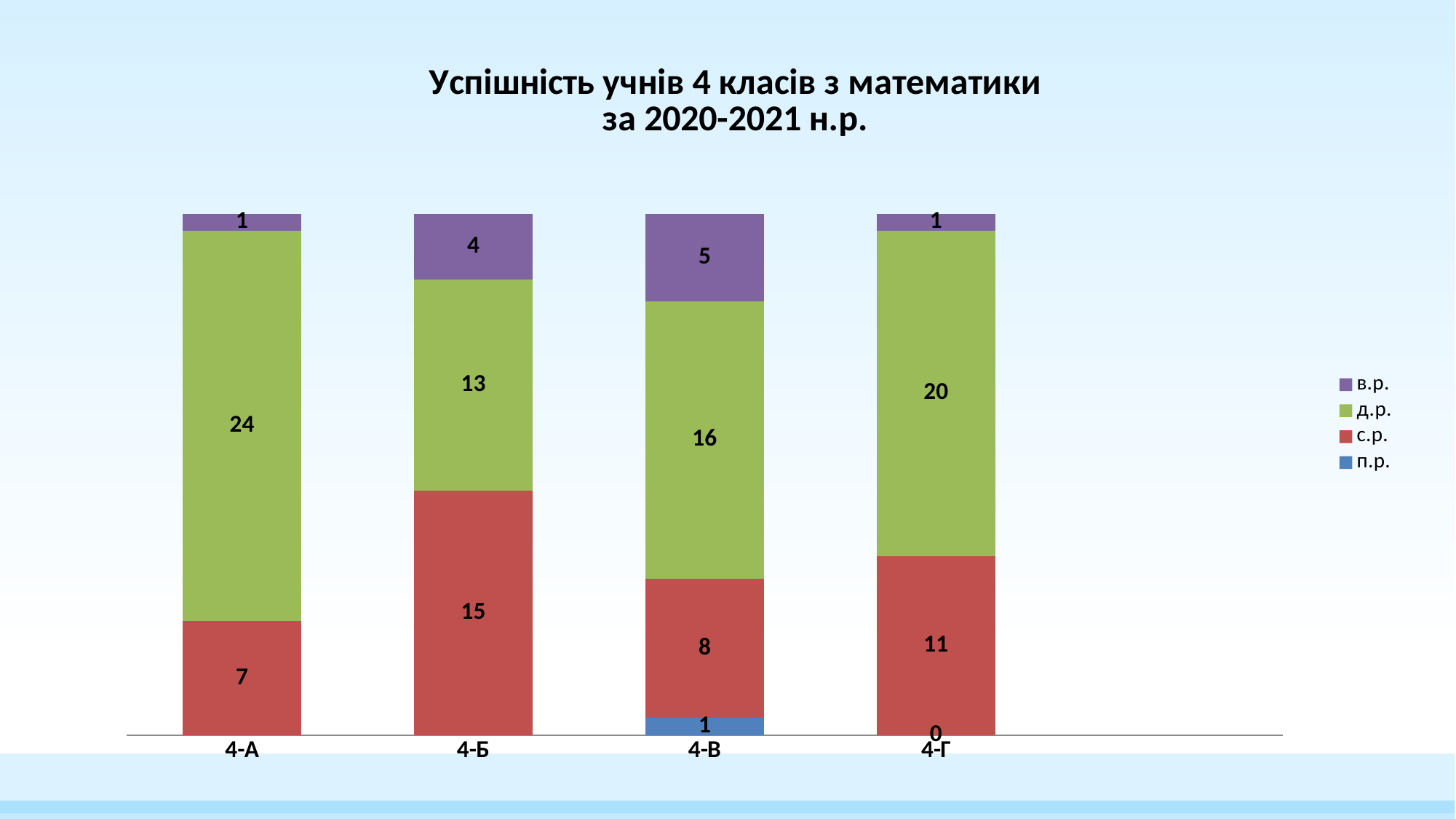
What is the total of all labelled segments in the bar for class 4-В? 30 What is the value of с.р. for class 4-Б? 15 What kind of chart is shown on the slide? Stacked bar chart Which class has a larger с.р. value, 4-Б or 4-Г? 4-Б Which class has the lowest value for с.р.? 4-А How many series does the legend list? 4 What is the value of в.р. for class 4-В? 5 What is the value of п.р. for class 4-В? 1 How many classes are shown on the x axis? 4 What is the value of д.р. for class 4-А? 24 What is the difference between the д.р. values for 4-Г and 4-Б? 7 Which class has the highest value for д.р.? 4-А